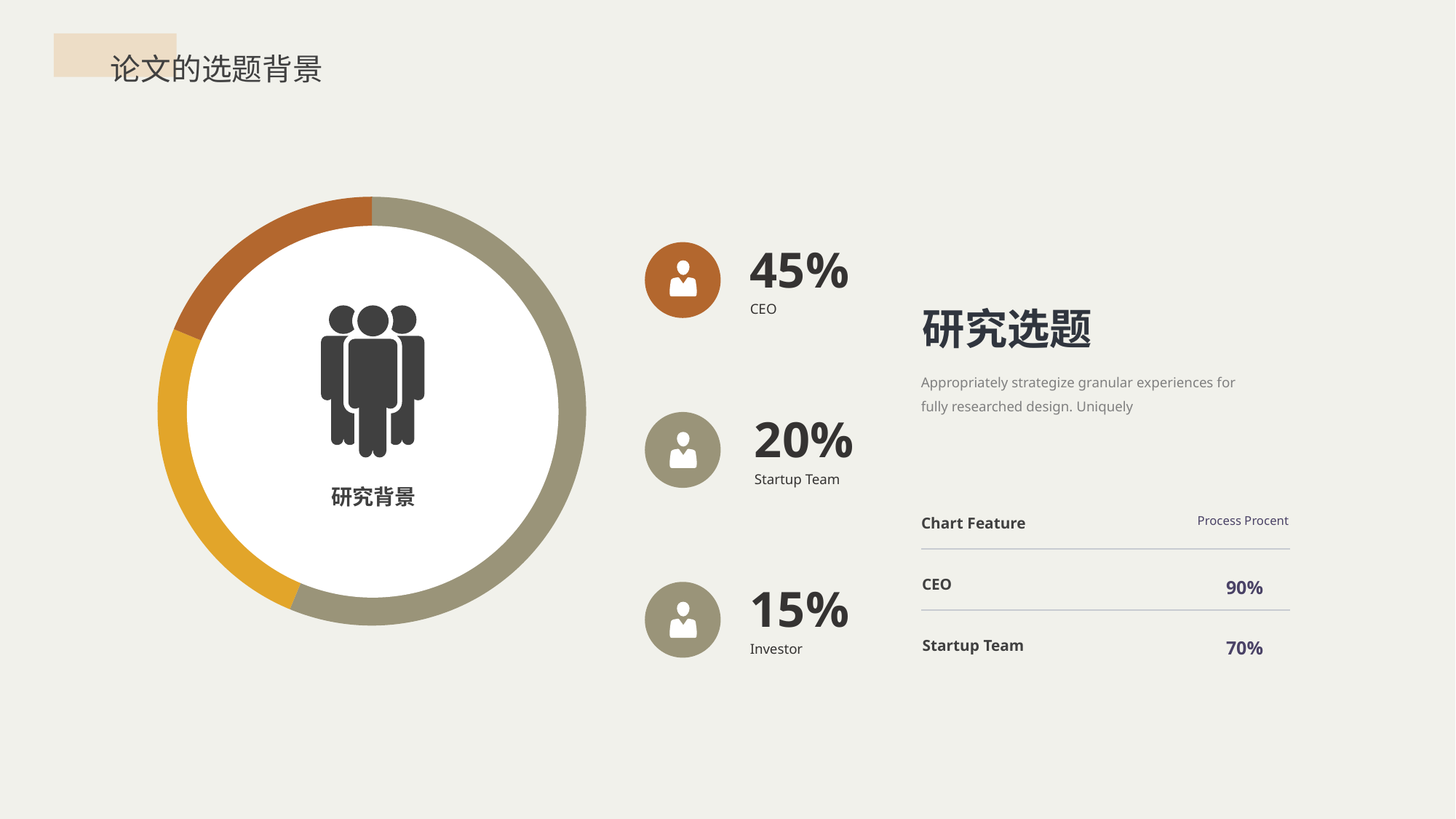
What is the total of the three percentages listed next to the donut chart (CEO, Startup Team, Investor)? 80% Which has the larger percentage shown next to the donut chart, CEO or Investor? CEO What is the difference between the percentages shown for CEO and Startup Team? 25% What percentage is shown for Startup Team next to the donut chart? 20% What text is printed in the centre of the donut chart? 研究背景 What percentage is shown for CEO next to the donut chart? 45% How many segments does the donut chart have? 3 Which colour segment of the donut chart is the largest? olive/khaki What colour is the icon next to the CEO percentage? orange What kind of chart is shown on the left of the slide? donut (pie) chart Which colour segment of the donut chart is the smallest? orange-brown What percentage is shown for Investor next to the donut chart? 15%